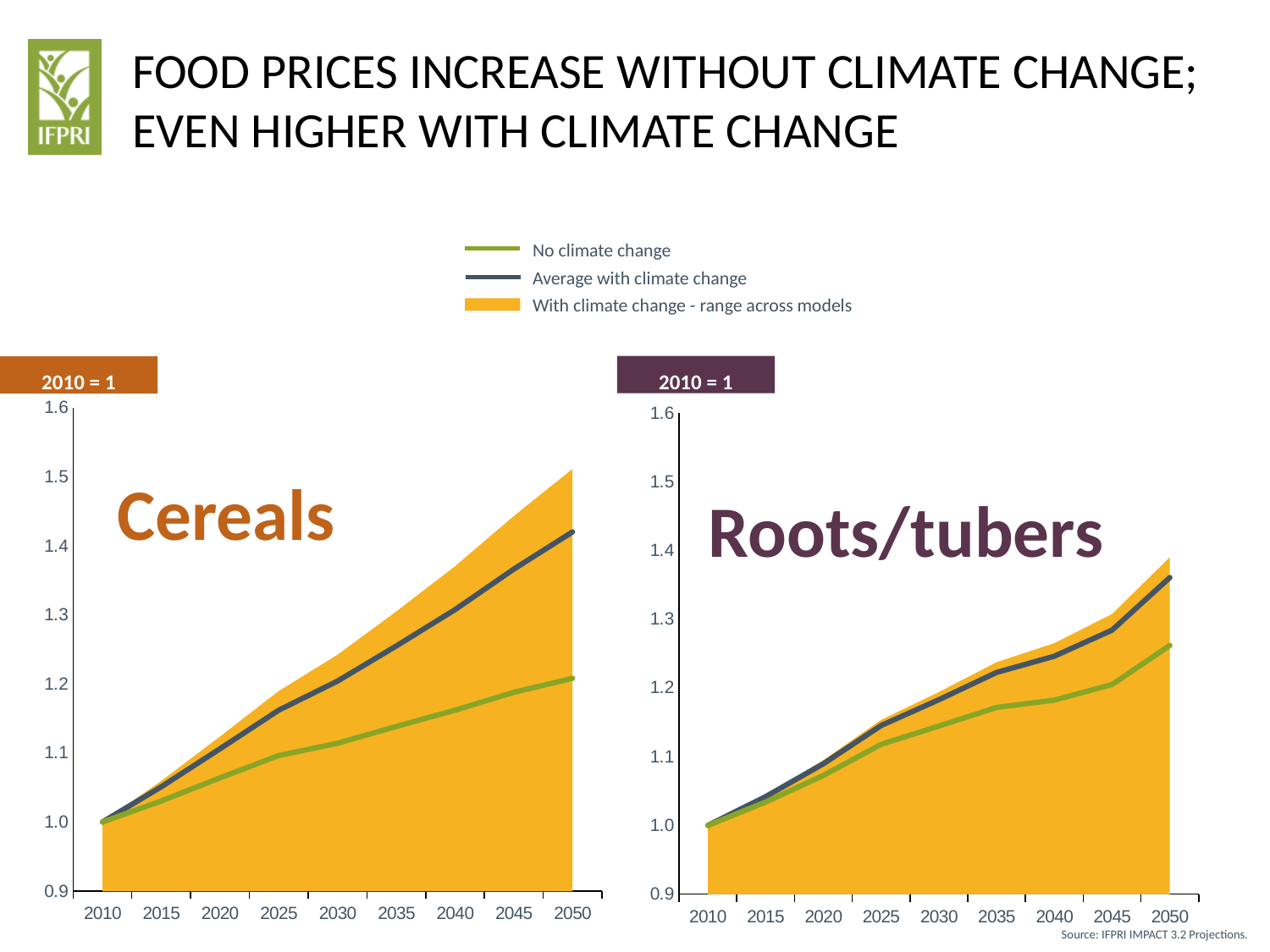
In the Cereals chart, what is the value of both series in 2010? 1.0 How many entries does the legend list? 3 In the Roots/tubers chart, is the Average with climate change value in 2050 greater or less than 1.3? greater What kind of chart is the Cereals chart? combination area and line chart In the Roots/tubers chart, do the values rise or fall from 2010 to 2050? rise What does the yellow shaded area represent according to the legend? With climate change - range across models In the Roots/tubers chart, is the No climate change value in 2050 greater or less than 1.3? less In the Cereals chart, is the Average with climate change value in 2050 greater or less than 1.4? greater In the Roots/tubers chart, what is the value of the No climate change series in 2010? 1.0 How many year labels are shown on the x axis of the Cereals chart? 9 In the Cereals chart, which series is higher in 2050: No climate change or Average with climate change? Average with climate change